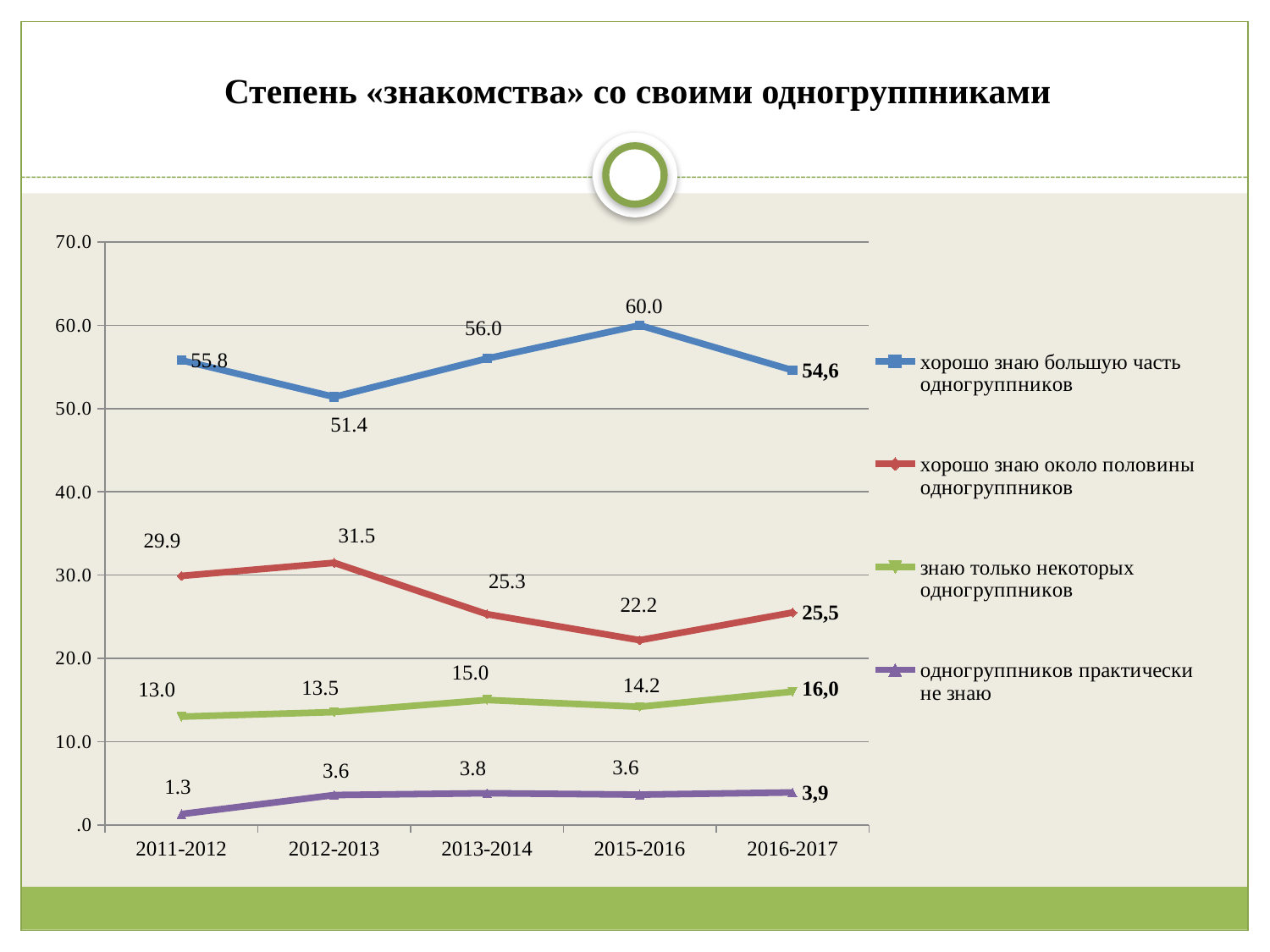
How many series does the legend list? 4 Which is larger: the value for «хорошо знаю около половины одногруппников» in 2012-2013 or in 2013-2014? 2012-2013 What is the value for «хорошо знаю около половины одногруппников» in 2016-2017? 25,5 How many academic years are shown on the x axis? 5 What type of chart is shown on the slide? line chart In which year is the value for «хорошо знаю около половины одногруппников» the lowest? 2015-2016 What is the value for «одногруппников практически не знаю» in 2011-2012? 1.3 In which year is the value for «хорошо знаю большую часть одногруппников» the highest? 2015-2016 What is the value for «знаю только некоторых одногруппников» in 2013-2014? 15.0 What is the difference between the highest and lowest values of «хорошо знаю большую часть одногруппников» (2015-2016 and 2012-2013)? 8.6 What is the value for «хорошо знаю большую часть одногруппников» in 2015-2016? 60.0 Does the value for «знаю только некоторых одногруппников» generally rise or fall from 2011-2012 to 2016-2017? rise